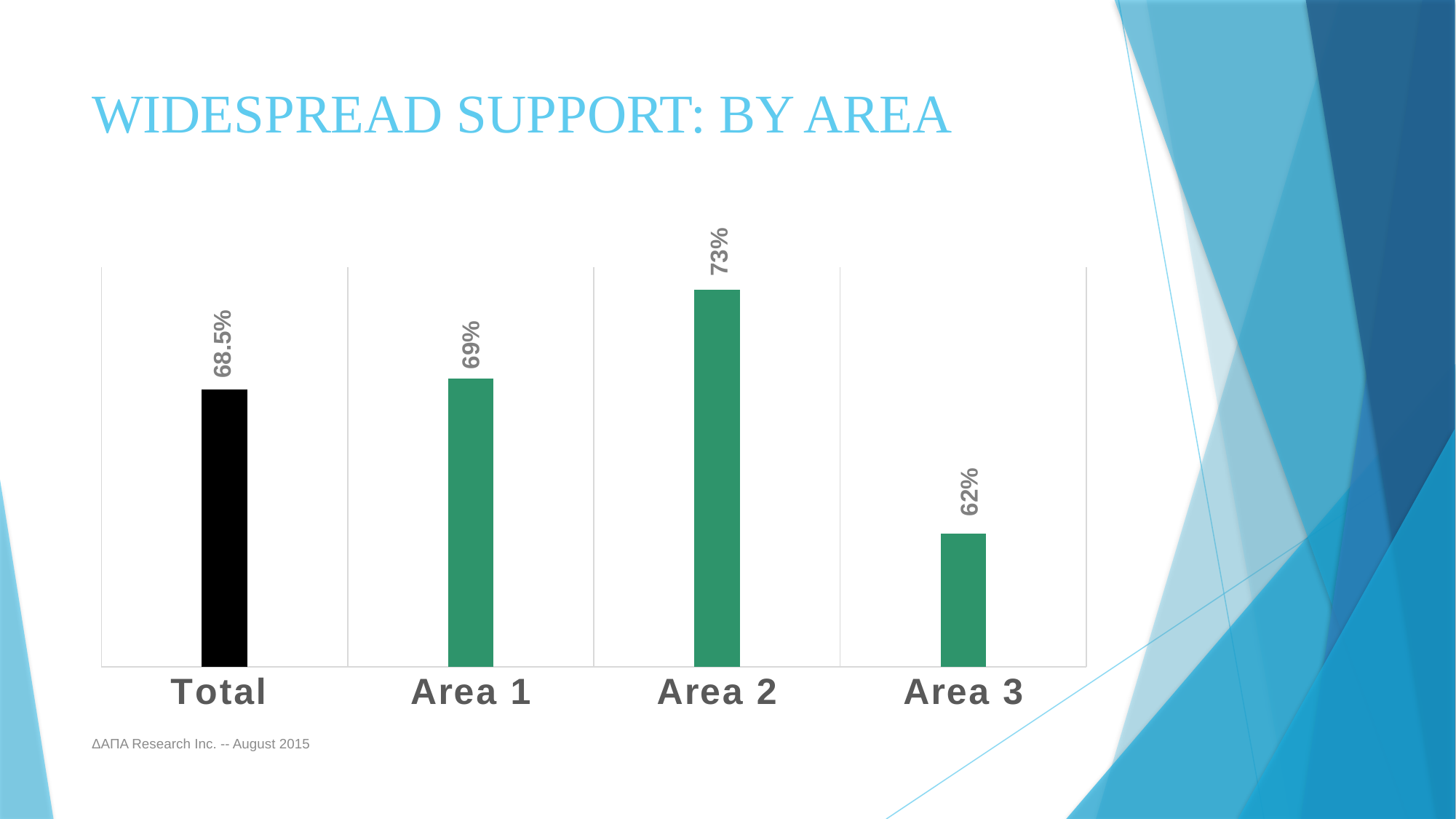
What kind of chart is shown on the slide? Bar chart What is the title of the slide containing the chart? WIDESPREAD SUPPORT: BY AREA How many categories are shown on the chart? 4 What is the value for Area 1? 69% What is the difference between the values for Area 1 and Total? 0.5% What is the difference between the values for Area 2 and Area 3? 11% Which is larger, the value for Area 2 or the value for Area 1? Area 2 What is the value for Area 2? 73% What is the value for Total? 68.5% Which category has the lowest value? Area 3 Which category has the highest value? Area 2 What is the value for Area 3? 62%